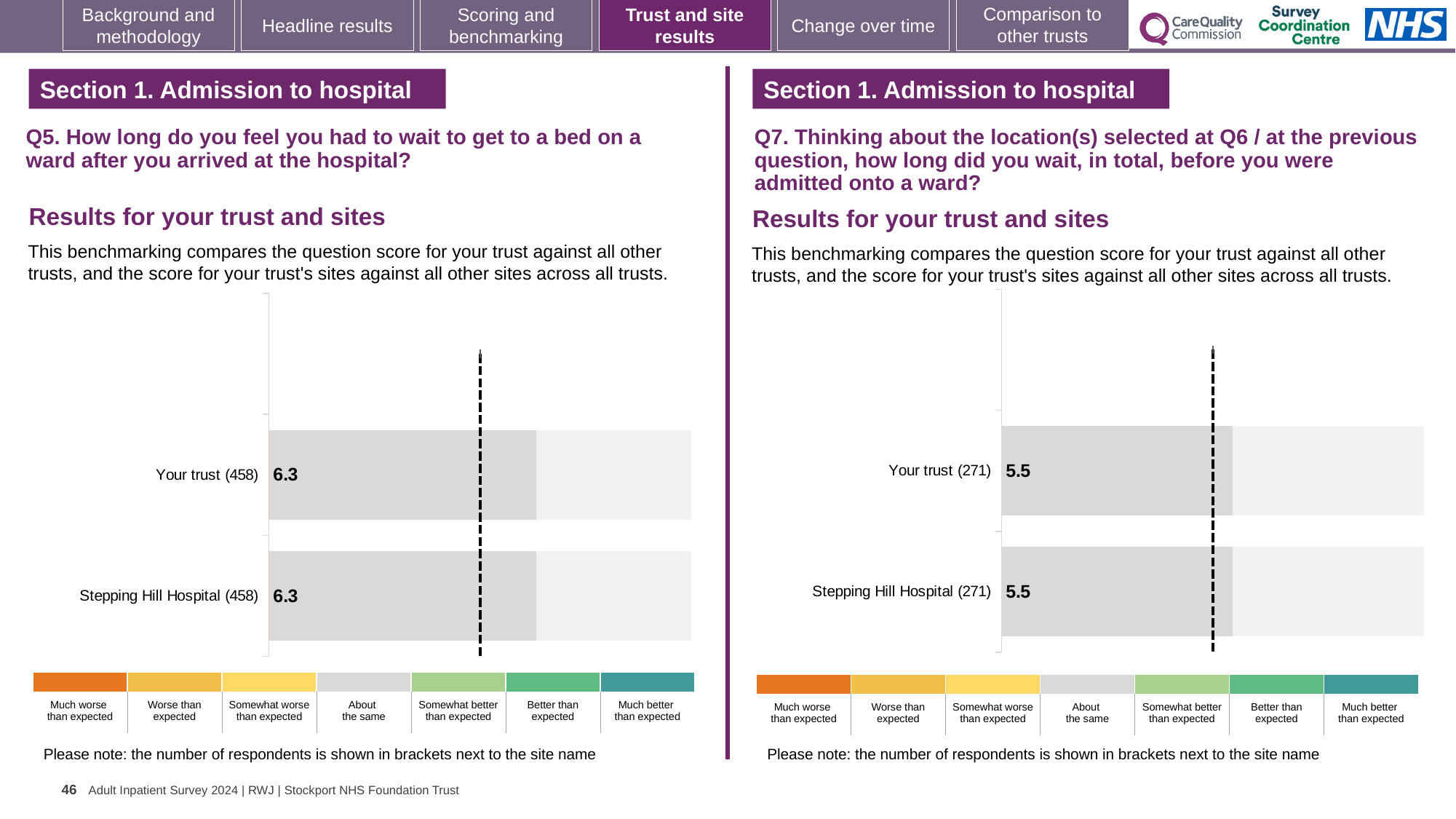
In the Q5 chart on the left, what is the difference between the score for Your trust and the score for Stepping Hill Hospital? 0.0 In the Q7 chart on the right, what is the score for Stepping Hill Hospital? 5.5 In the Q5 chart on the left, how many respondents are shown in brackets next to Your trust? 458 In the Q7 chart on the right, is the score for Your trust greater or less than the score for Stepping Hill Hospital, or are they equal? Equal In the Q5 chart on the left, what is the score for Your trust? 6.3 In the Q7 chart on the right, what is the score for Your trust? 5.5 In the Q7 chart on the right, how many respondents are shown in brackets next to Stepping Hill Hospital? 271 How many bars are plotted in the Q5 chart on the left? 2 What kind of chart is the Q5 chart on the left? Bar chart In the Q5 chart on the left, what is the score for Stepping Hill Hospital? 6.3 How many bars are plotted in the Q7 chart on the right? 2